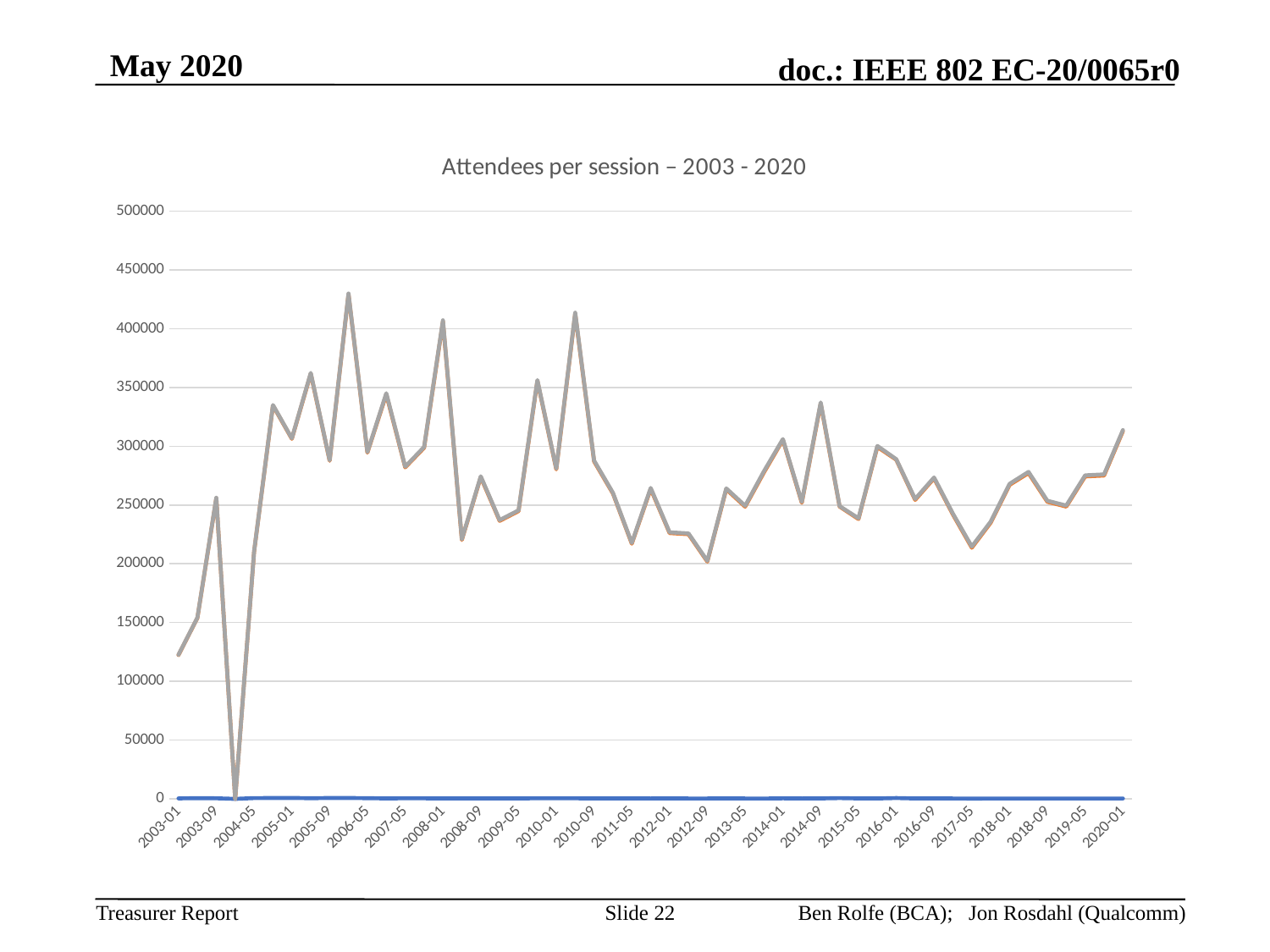
Is the value for 2003-01 greater or less than 150000? less What is the title of the chart? Attendees per session – 2003 - 2020 Is the value for 2014-09 greater or less than 300000? greater Which has the larger value, 2003-01 or 2020-01? 2020-01 Is the value for 2008-01 greater or less than 350000? greater What kind of chart is shown on the slide? line chart Which has the larger value, 2005-01 or 2011-05? 2005-01 Does the value rise or fall from 2017-05 to 2020-01? rise